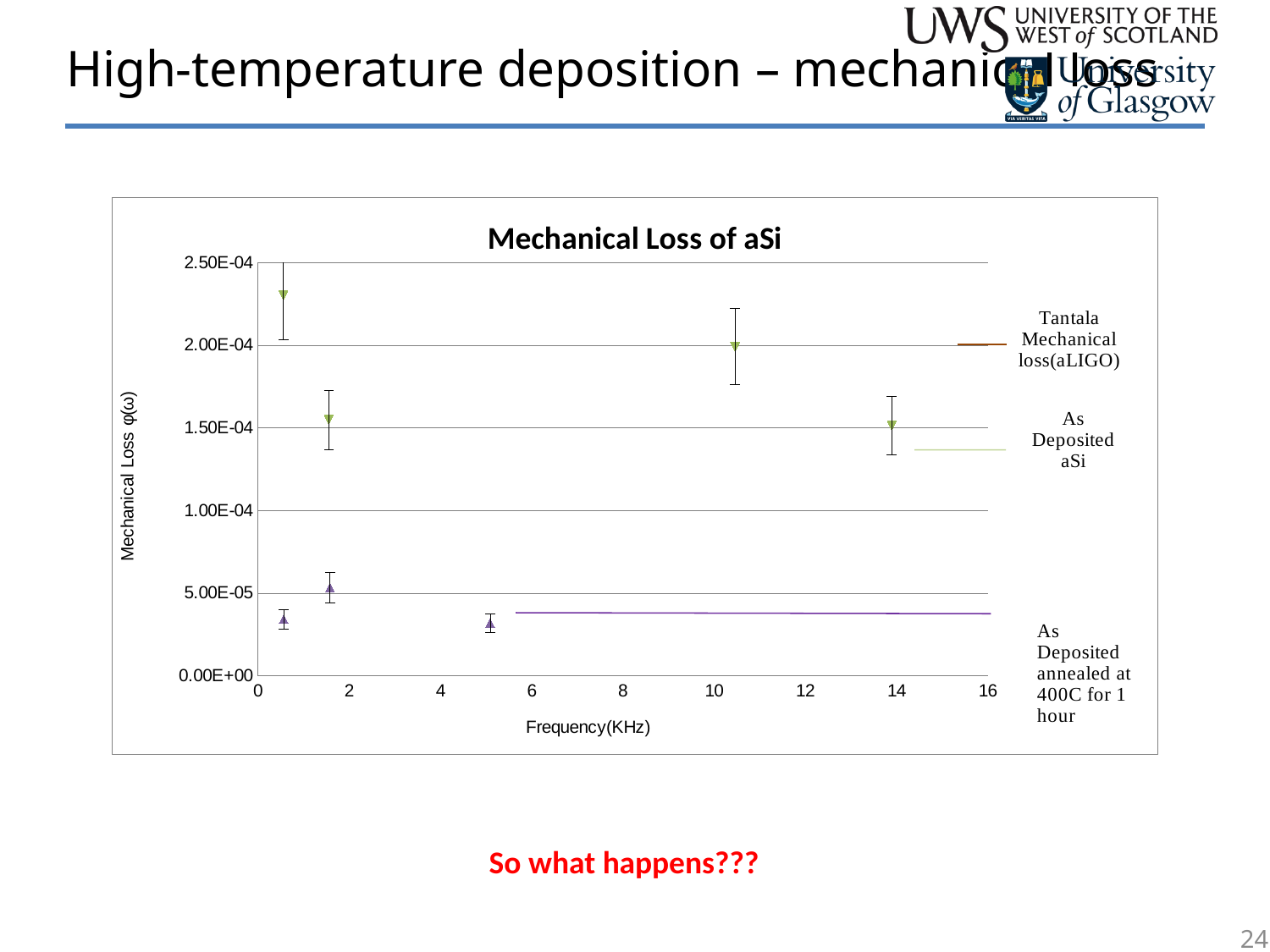
Is the As Deposited annealed at 400C for 1 hour value at around 0.5 kHz greater or less than 5.00E-05? less Is the As Deposited aSi value at around 1.6 kHz greater or less than 1.00E-04? greater How many data points are plotted for the As Deposited annealed at 400C for 1 hour series? 3 At around 1.6 kHz, which series has the larger mechanical loss: As Deposited aSi or As Deposited annealed at 400C for 1 hour? As Deposited aSi How many data points are plotted for the As Deposited aSi series? 4 Is the As Deposited aSi value at the lowest frequency (around 0.5 kHz) greater or less than 2.00E-04? greater What is the label of the x axis of the chart? Frequency(KHz) What is the title of the chart? Mechanical Loss of aSi Which series has the lowest mechanical loss values overall? As Deposited annealed at 400C for 1 hour What kind of chart is shown on the slide? Scatter chart How many series does the chart's legend list? 3